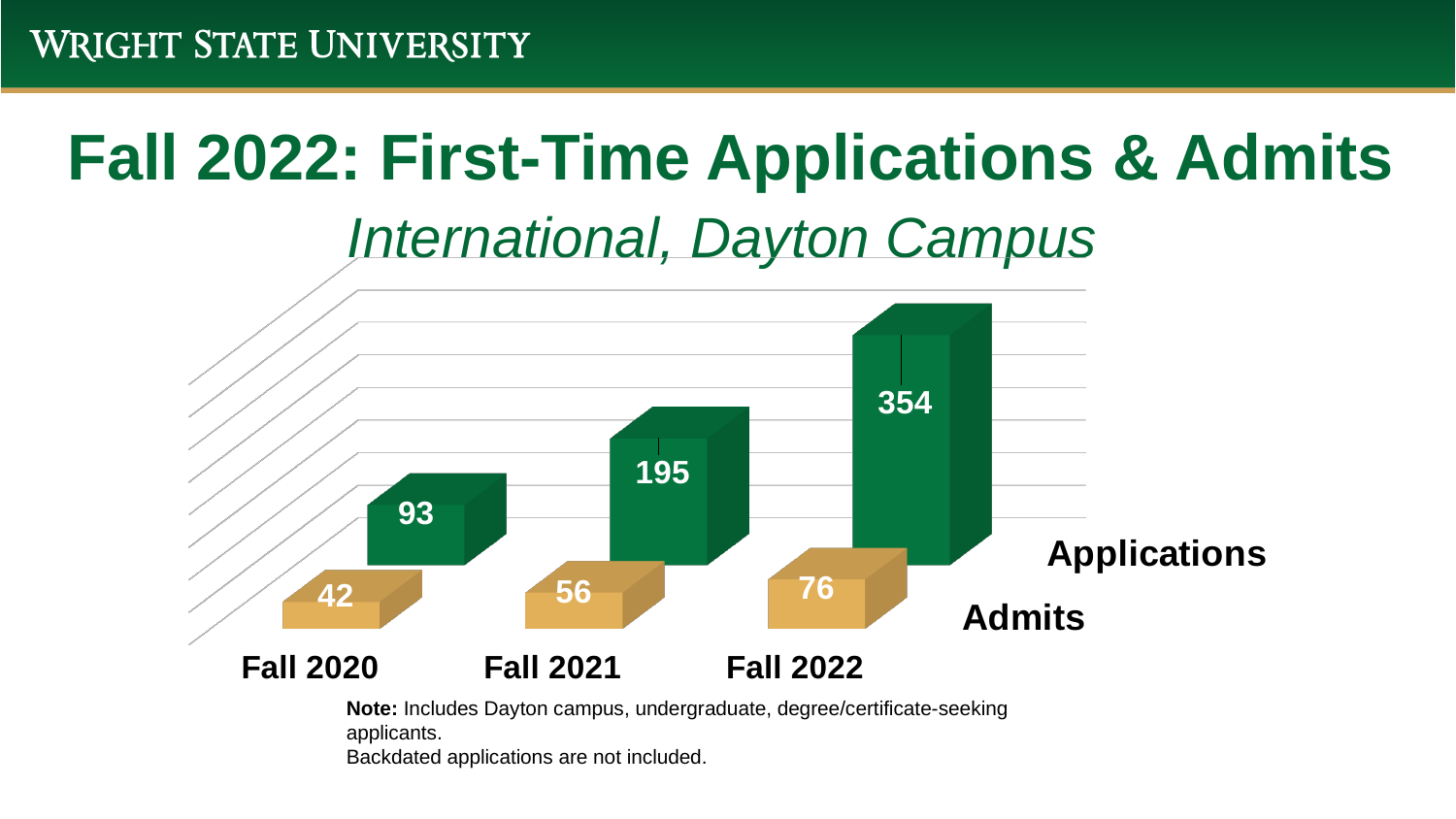
Which term has the lowest number of admits? Fall 2020 How many admits were there for Fall 2022? 76 By how much did applications increase from Fall 2020 to Fall 2021? 102 Which is larger: admits for Fall 2021 or admits for Fall 2022? Fall 2022 How many applications were there for Fall 2021? 195 Do applications rise or fall from Fall 2020 to Fall 2022? rise How many admits were there for Fall 2020? 42 How many terms are shown on the chart? 3 How many first-time applications were there for Fall 2022? 354 What is the difference between applications and admits for Fall 2022? 278 Which term has the highest number of applications? Fall 2022 How many series does the chart show? 2